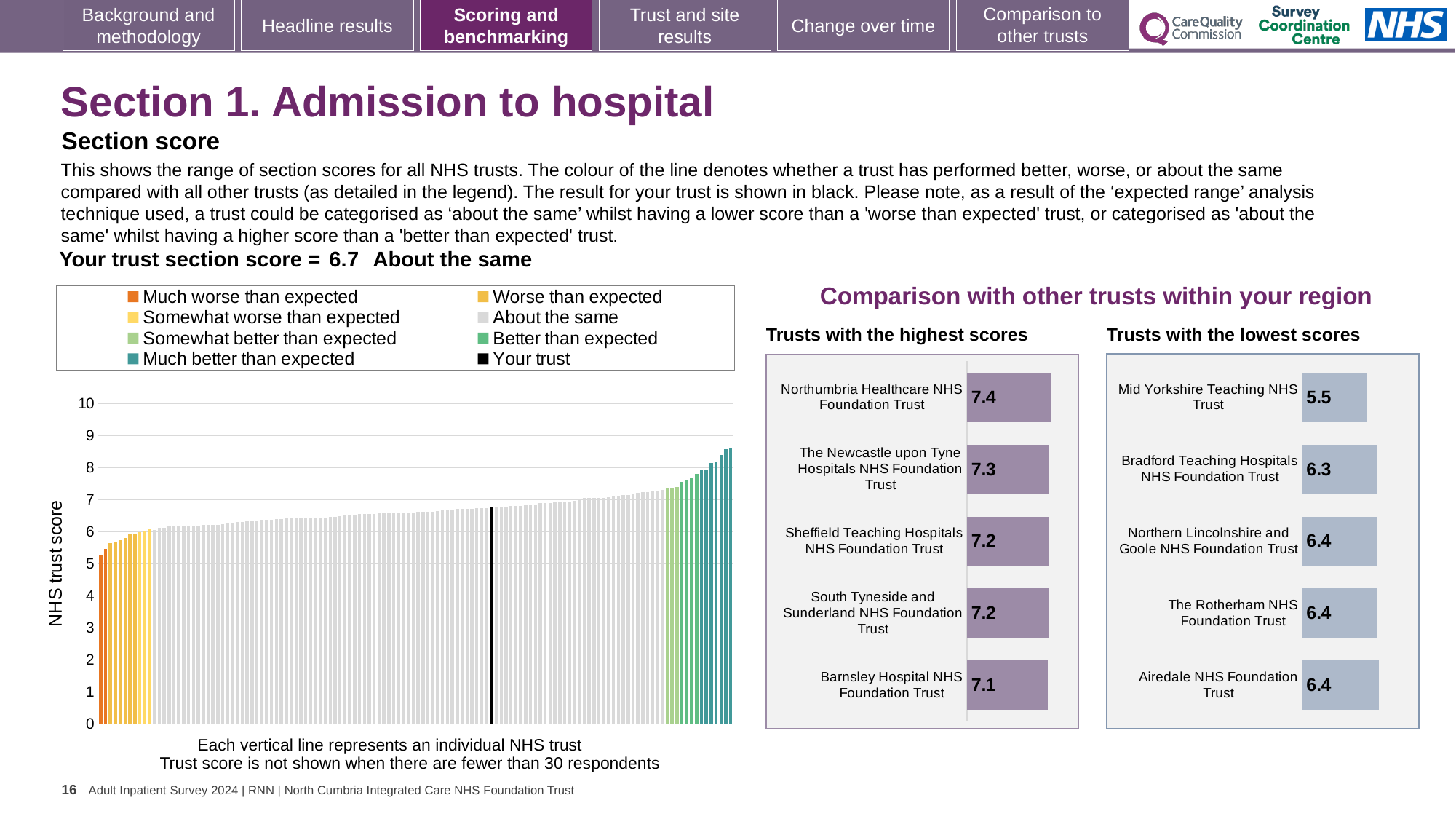
In the 'Trusts with the highest scores' chart, which trust has the highest score? Northumbria Healthcare NHS Foundation Trust In the 'Trusts with the lowest scores' chart, which trust has the lowest score? Mid Yorkshire Teaching NHS Trust In the main NHS trust score chart on the left, what is the section score for your trust? 6.7 In the 'Trusts with the highest scores' chart, what is the score for Northumbria Healthcare NHS Foundation Trust? 7.4 How many entries does the legend of the main NHS trust score chart list? 8 In the 'Trusts with the highest scores' chart, what is the difference between the scores of Northumbria Healthcare NHS Foundation Trust and Barnsley Hospital NHS Foundation Trust? 0.3 In the 'Trusts with the lowest scores' chart, what is the score for Mid Yorkshire Teaching NHS Trust? 5.5 In the main NHS trust score chart on the left, is the value of the tallest bar greater or less than 8? greater How many trusts are shown in the 'Trusts with the highest scores' chart? 5 In the 'Trusts with the lowest scores' chart, what is the difference between the scores of Bradford Teaching Hospitals NHS Foundation Trust and Mid Yorkshire Teaching NHS Trust? 0.8 In the 'Trusts with the lowest scores' chart, which has the higher score: Mid Yorkshire Teaching NHS Trust or Bradford Teaching Hospitals NHS Foundation Trust? Bradford Teaching Hospitals NHS Foundation Trust In the 'Trusts with the highest scores' chart, what is the score for Barnsley Hospital NHS Foundation Trust? 7.1